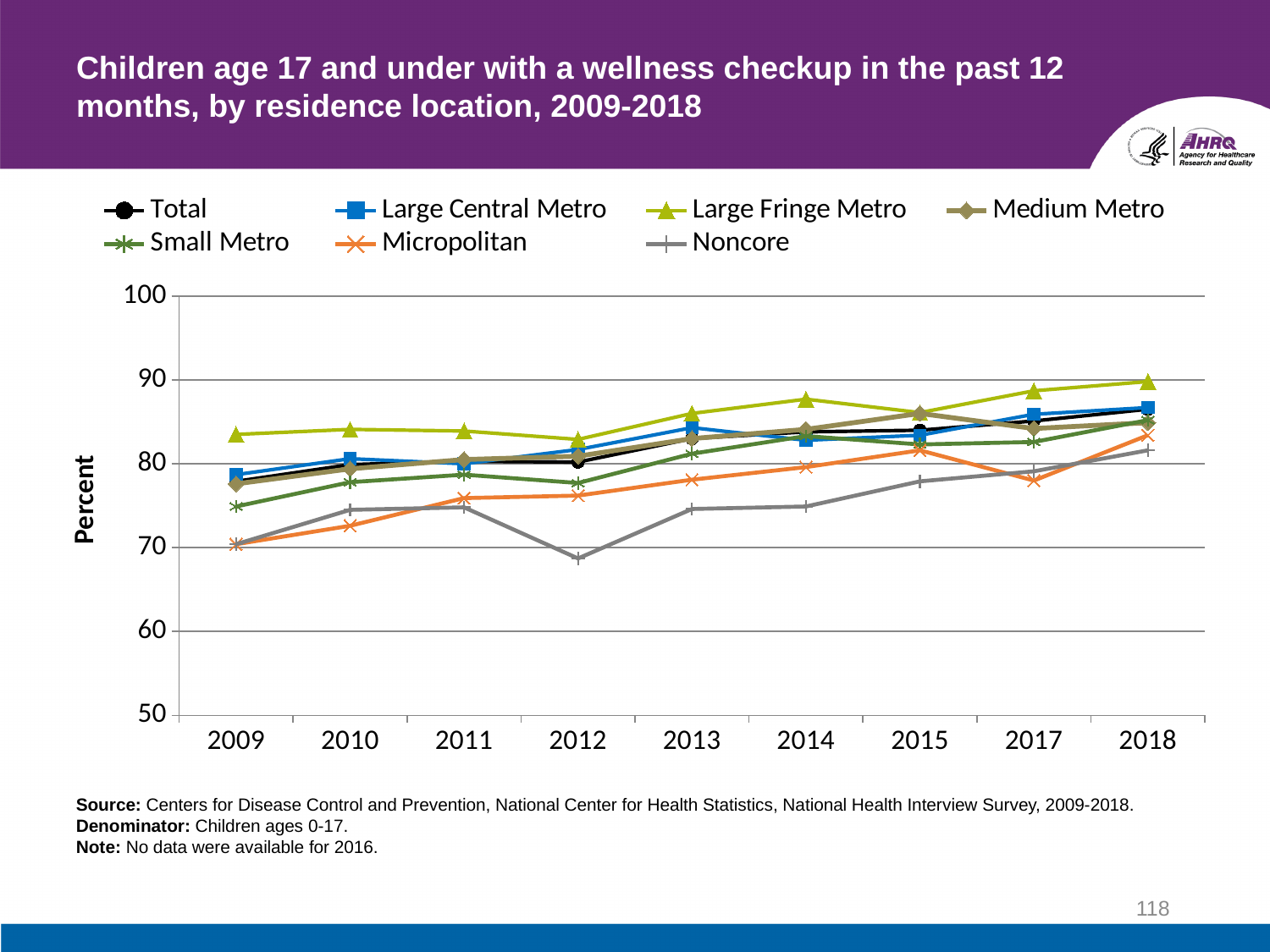
In 2014, which is larger: Micropolitan or Noncore? Micropolitan Does the Total series rise or fall from 2009 to 2018? rise Is the value for Noncore in 2012 greater or less than 70? less What is the label on the y axis? Percent Which series has the highest value in 2009? Large Fringe Metro Is the value for Large Fringe Metro in 2009 greater or less than 80? greater How many series does the legend list? 7 In 2018, which is larger: Large Fringe Metro or Noncore? Large Fringe Metro Which series has the lowest value in 2012? Noncore What kind of chart is shown on the slide? line chart Is the value for Micropolitan in 2009 greater or less than 80? less How many years are shown on the x axis? 9